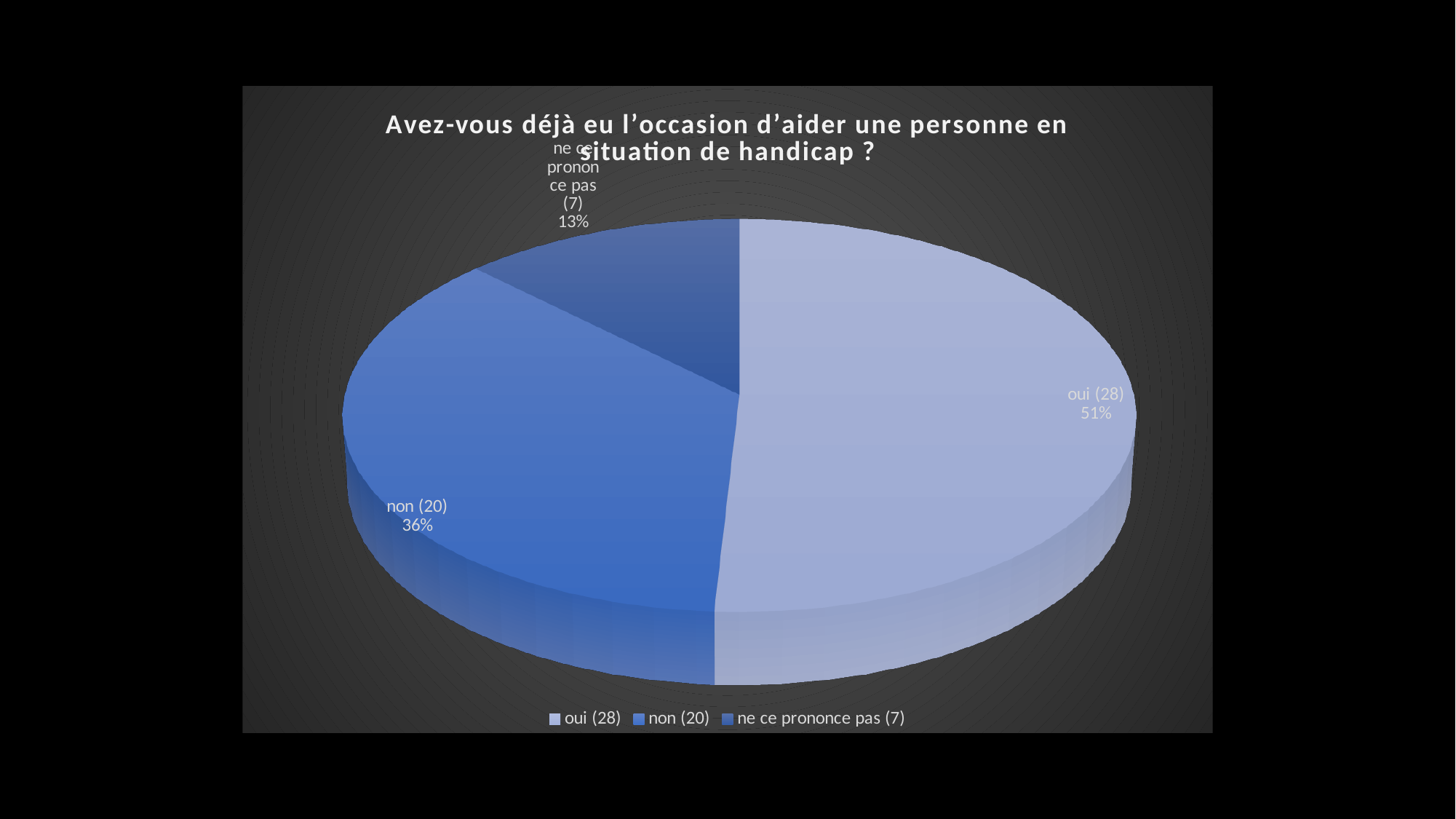
How many respondents answered "non" according to the chart labels? 20 Which category has the largest slice of the pie? oui (28) What is the title of the chart? Avez-vous déjà eu l'occasion d'aider une personne en situation de handicap ? How many entries does the legend list? 3 What is the difference in percentage points between the "oui (28)" slice and the "non (20)" slice? 15% What percentage of the pie does the "non (20)" slice represent? 36% Which category has the smallest slice of the pie? ne ce prononce pas (7) How many categories does the pie chart show? 3 What kind of chart is shown on the slide? pie chart What percentage of the pie does the "oui (28)" slice represent? 51% Which slice is larger, "non (20)" or "ne ce prononce pas (7)"? non (20) What percentage of the pie does the "ne ce prononce pas (7)" slice represent? 13%